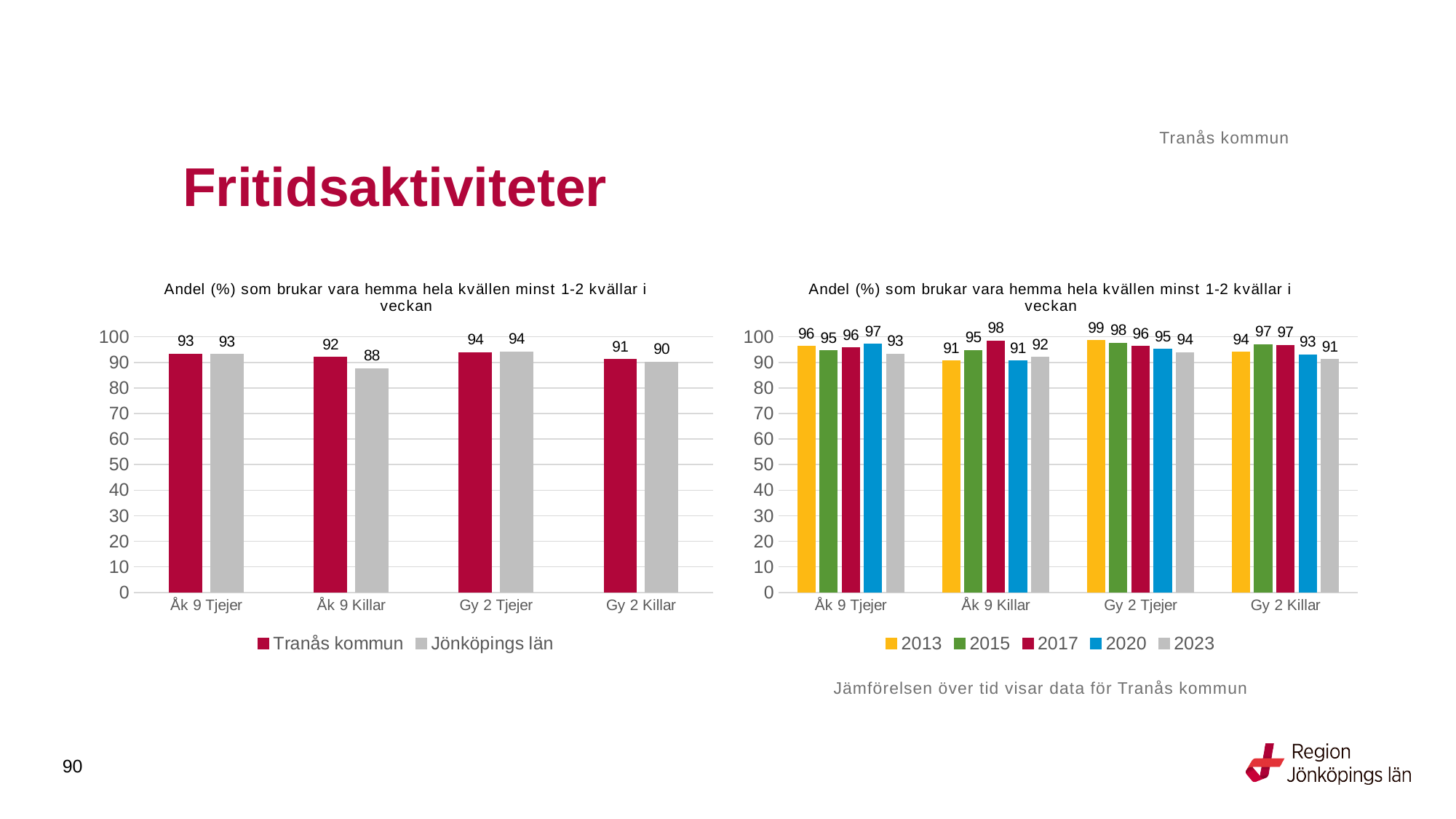
In the right chart, how many series does the legend list? 5 What kind of chart is the left chart? bar chart In the right chart, which year has the highest value for Gy 2 Tjejer? 2013 In the left chart, how many series does the legend list? 2 In the right chart, what is the value for 2023 for Gy 2 Killar? 91 In the right chart, what is the value for 2017 for Åk 9 Killar? 98 In the left chart, which category has the lowest value for Jönköpings län? Åk 9 Killar In the left chart, what is the value for Tranås kommun for Gy 2 Tjejer? 94 In the left chart, what is the value for Jönköpings län for Åk 9 Killar? 88 In the right chart, do the values for Gy 2 Tjejer rise or fall from 2013 to 2023? fall In the left chart, what is the difference between Tranås kommun and Jönköpings län for Åk 9 Killar? 4 In the right chart, is the value for 2013 for Åk 9 Tjejer larger or smaller than the value for 2013 for Åk 9 Killar? larger